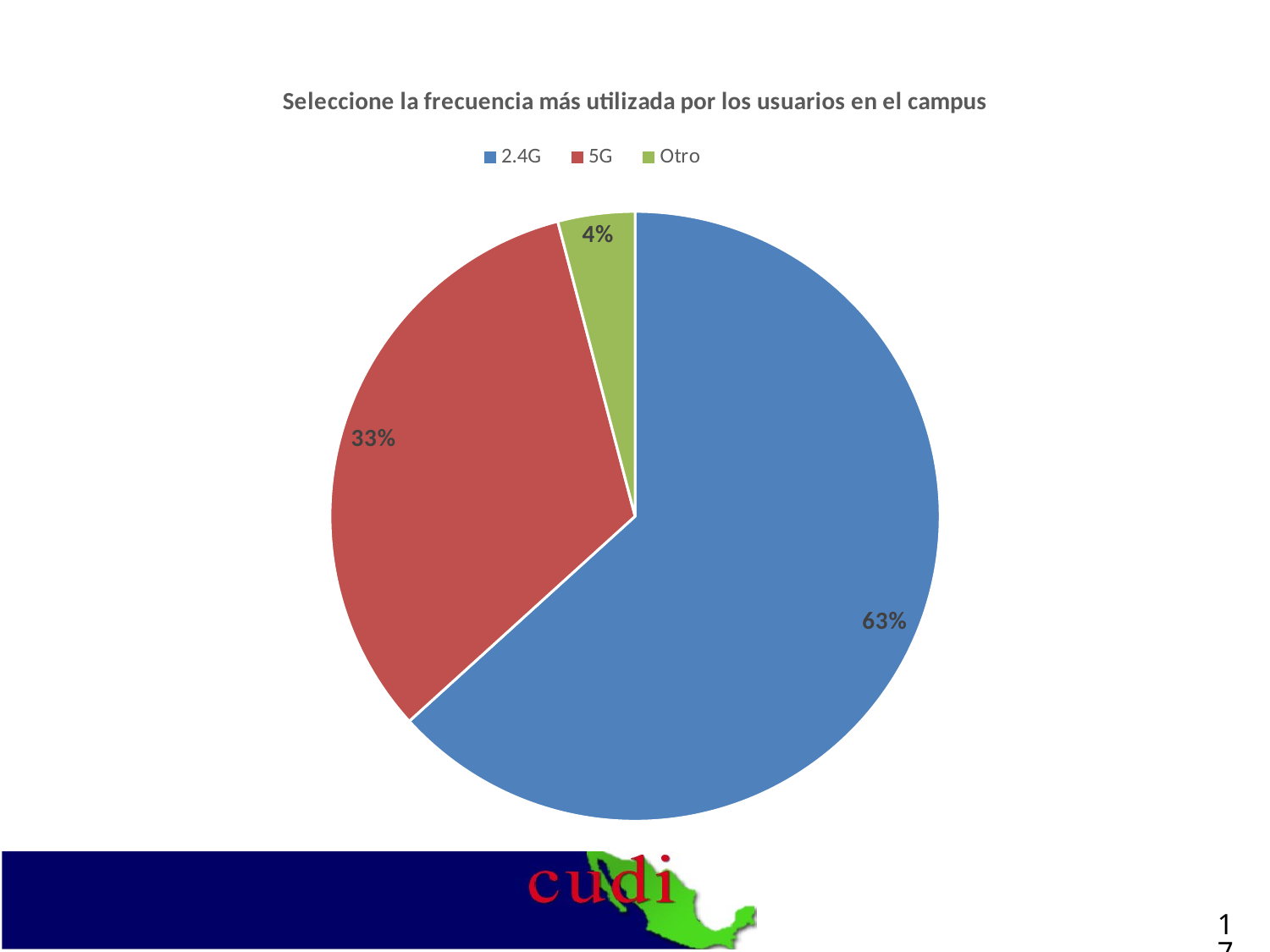
What is the difference in percentage points between the 2.4G slice and the 5G slice? 30 What colour is the 5G slice in the pie chart? Red What share of the pie does 2.4G represent? 63% What is the title of the chart? Seleccione la frecuencia más utilizada por los usuarios en el campus Which category has the smallest slice of the pie? Otro Which category has the largest slice of the pie? 2.4G What share of the pie does Otro represent? 4% What share of the pie does 5G represent? 33% How many categories are shown in the pie chart? 3 What is the difference in percentage points between the 5G slice and the Otro slice? 29 What kind of chart is shown on the slide? Pie chart Which slice is larger, 5G or Otro? 5G